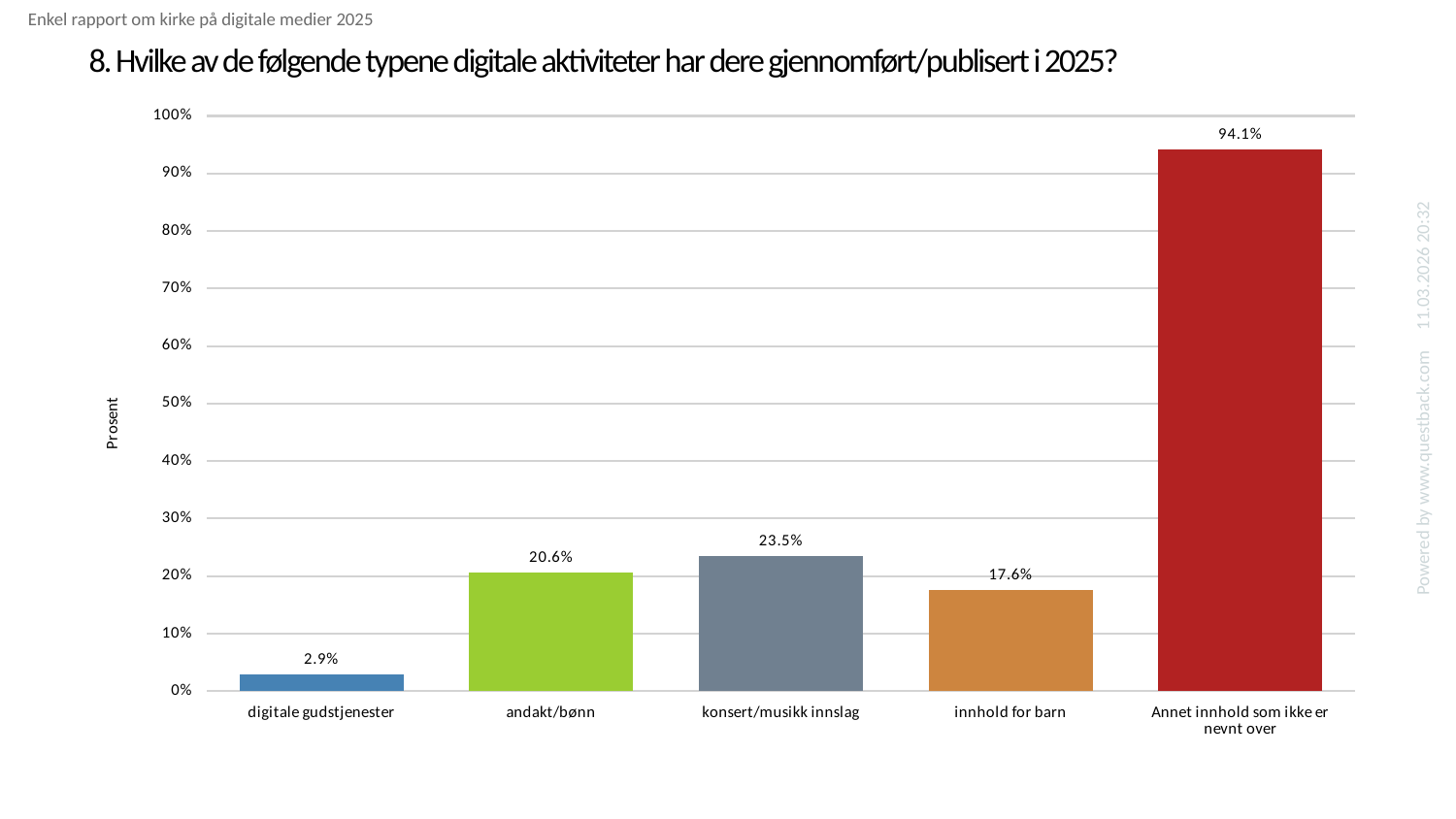
What is the value for "konsert/musikk innslag"? 23.5% Which is larger, the value for "andakt/bønn" or the value for "innhold for barn"? andakt/bønn How many categories are shown on the x axis? 5 Is the value for "Annet innhold som ikke er nevnt over" greater or less than 90%? greater What is the label of the y axis? Prosent What is the difference between the values for "Annet innhold som ikke er nevnt over" and "konsert/musikk innslag"? 70.6% Which category has the highest value? Annet innhold som ikke er nevnt over What is the value for "innhold for barn"? 17.6% What kind of chart is shown on the slide? bar chart Which category has the lowest value? digitale gudstjenester What is the value for "digitale gudstjenester"? 2.9% What is the value for "andakt/bønn"? 20.6%